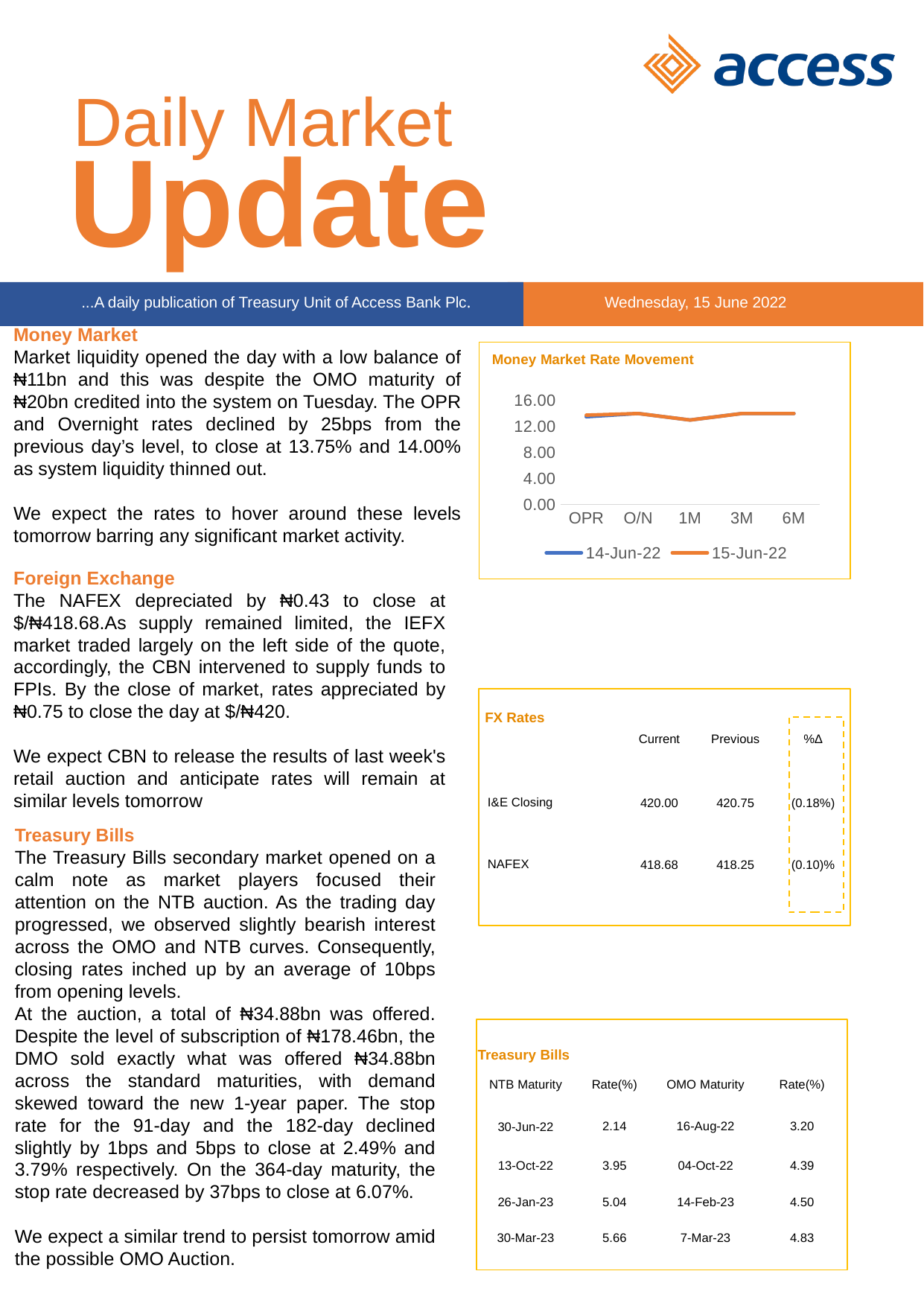
In the Money Market Rate Movement chart, is the 15-Jun-22 value for 6M greater or less than 16.00? less How many series does the legend of the Money Market Rate Movement chart list? 2 How many categories are shown on the x axis of the Money Market Rate Movement chart? 5 What is the title of the line chart on the slide? Money Market Rate Movement What is the highest tick value shown on the y axis of the Money Market Rate Movement chart? 16.00 In the Money Market Rate Movement chart, is the 15-Jun-22 value for O/N greater or less than 12.00? greater In the Money Market Rate Movement chart, which category has the lowest value for the 15-Jun-22 series? 1M What kind of chart is the Money Market Rate Movement chart? line chart Which two series are listed in the legend of the Money Market Rate Movement chart? 14-Jun-22 and 15-Jun-22 In the Money Market Rate Movement chart, is the 15-Jun-22 value for OPR greater or less than 12.00? greater